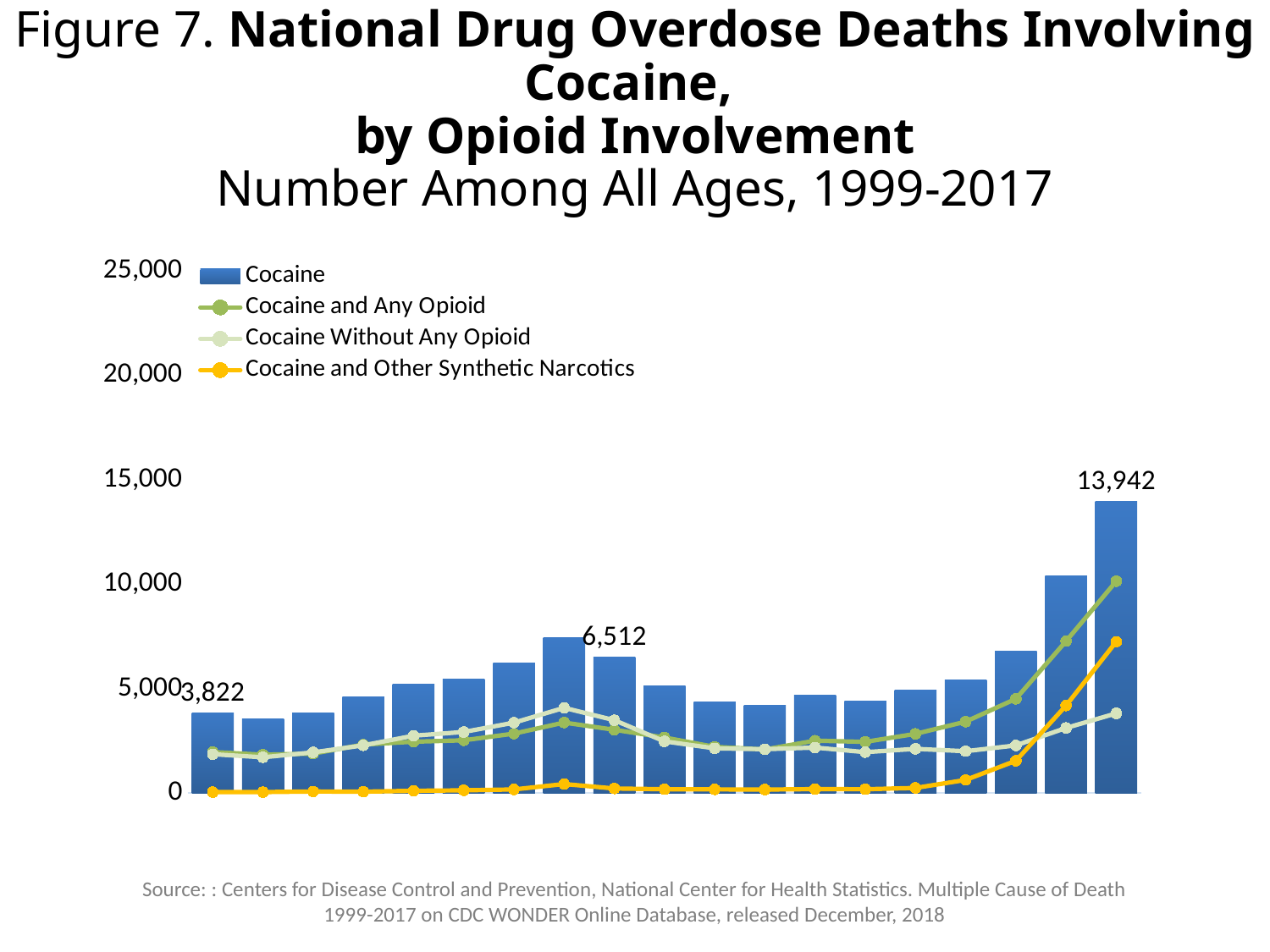
Which bar has the highest value for Cocaine deaths? The last bar on the right (2017), 13,942 What is the value of the first Cocaine bar on the left (1999)? 3,822 What is the difference between the highest labelled Cocaine value (13,942) and the first labelled value (3,822)? 10,120 Which series is shown as a yellow line? Cocaine and Other Synthetic Narcotics What kind of chart is this? A combination bar and line chart Is the final value of the Cocaine and Other Synthetic Narcotics line greater or less than 5,000? greater What is the difference between the labelled values 13,942 and 6,512? 7,430 How many series does the legend list? 4 Which is larger, the labelled Cocaine value 6,512 or the labelled value 3,822? 6,512 What is the value of the tallest Cocaine bar, at the far right of the chart? 13,942 Is the final value of the Cocaine Without Any Opioid line greater or less than 5,000? less What is the value of the labelled Cocaine bar that peaks in the middle of the chart? 6,512